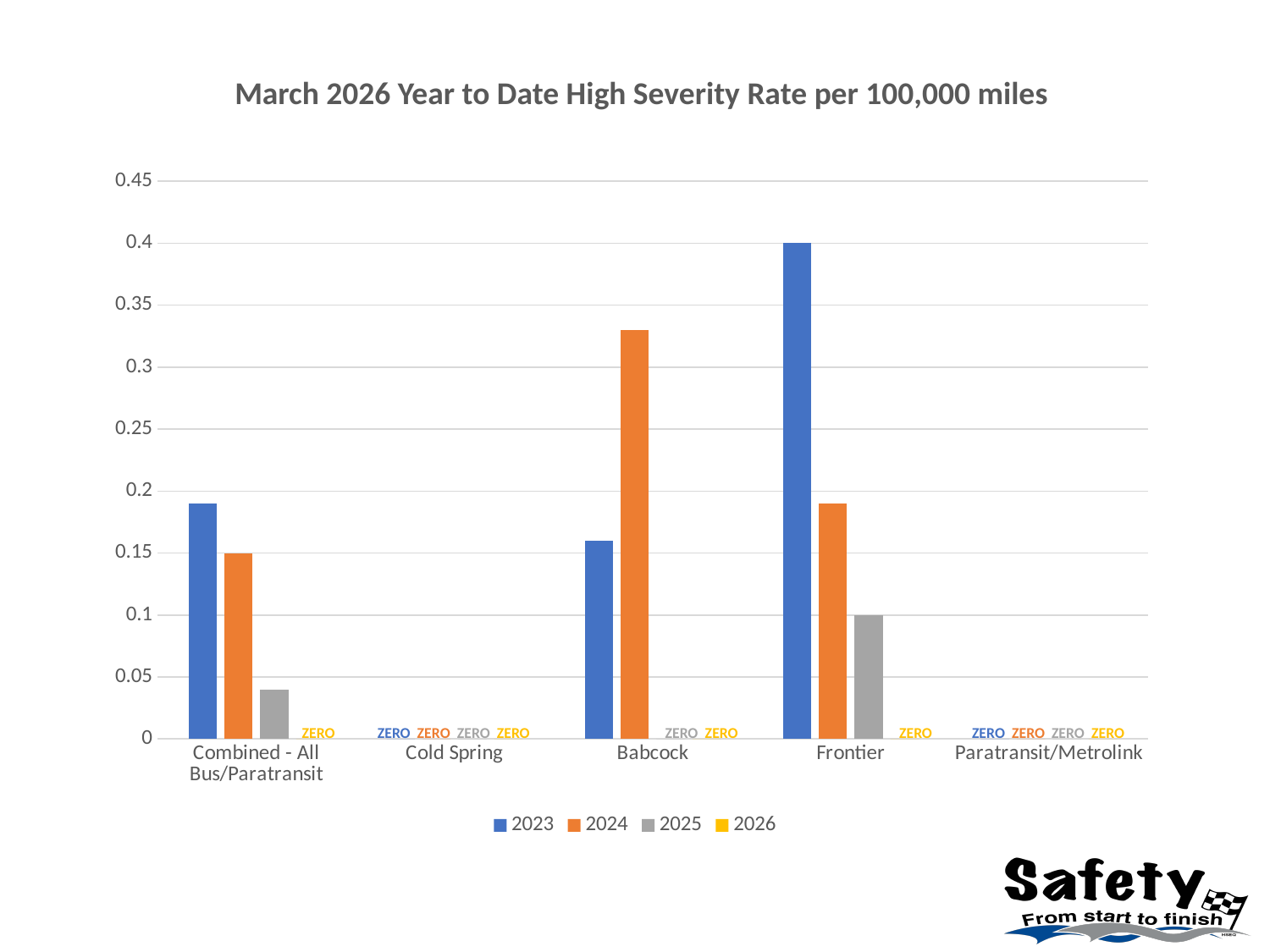
Is the 2025 value for Combined - All Bus/Paratransit greater or less than 0.05? less What kind of chart is shown on the slide? bar chart What is the 2026 value for Cold Spring? ZERO Which category has the highest 2023 value? Frontier Which category has the highest 2024 value? Babcock How many categories are shown on the x axis? 5 What is the 2025 value for Babcock? ZERO What is the 2024 value for Paratransit/Metrolink? ZERO How many series does the legend list? 4 For Babcock, which is larger, the 2023 value or the 2024 value? 2024 Is the 2024 value for Babcock greater or less than 0.3? greater What is the title of the chart? March 2026 Year to Date High Severity Rate per 100,000 miles